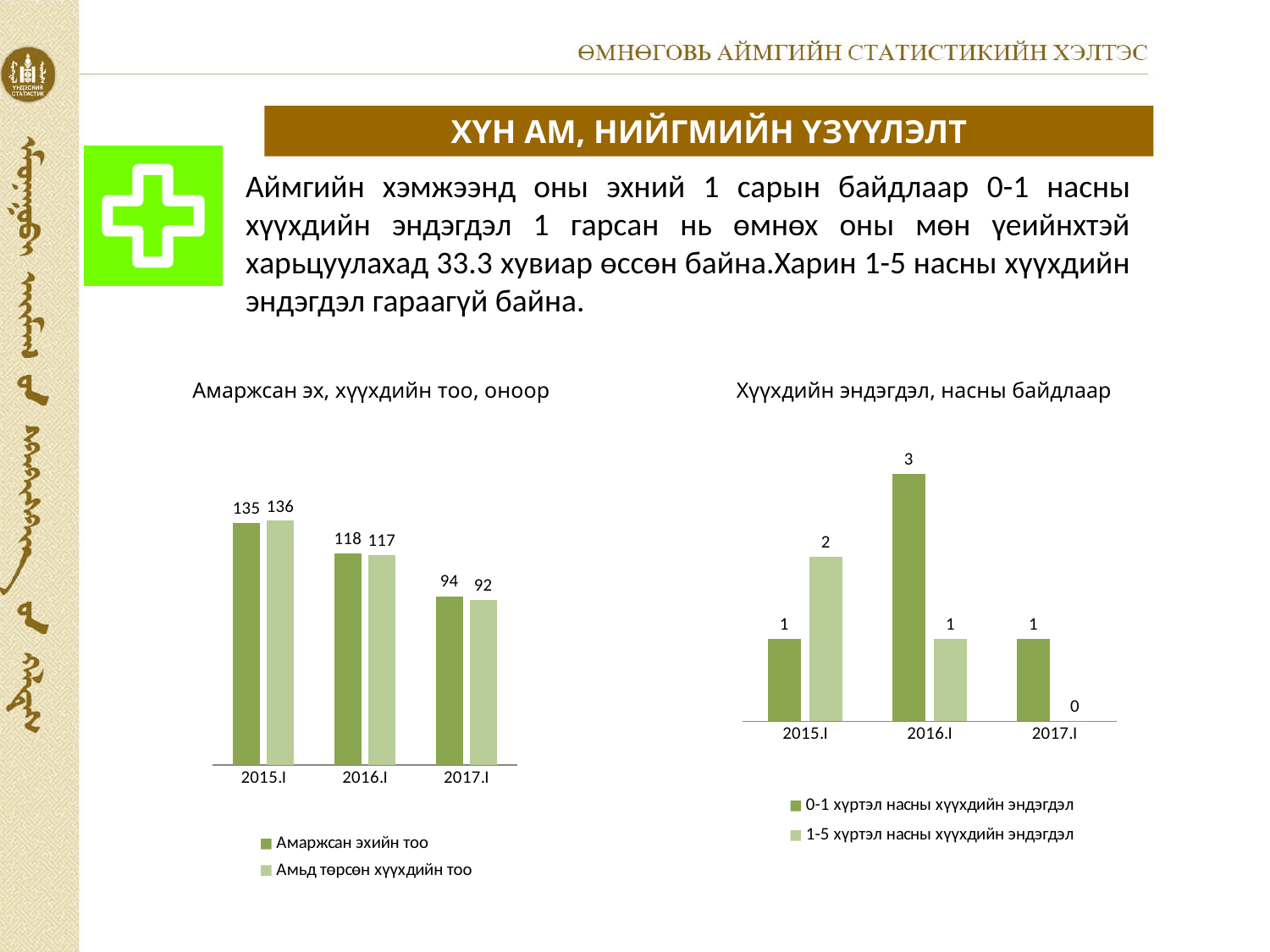
In the chart 'Хүүхдийн эндэгдэл, насны байдлаар', what is the value of '0-1 хүртэл насны хүүхдийн эндэгдэл' for 2016.I? 3 In the chart 'Амаржсан эх, хүүхдийн тоо, оноор', what is the value of 'Амьд төрсөн хүүхдийн тоо' for 2017.I? 92 In the chart 'Амаржсан эх, хүүхдийн тоо, оноор', which period has the lowest value for 'Амаржсан эхийн тоо'? 2017.I In the chart 'Амаржсан эх, хүүхдийн тоо, оноор', how many series does the legend list? 2 In the chart 'Амаржсан эх, хүүхдийн тоо, оноор', what is the value of 'Амаржсан эхийн тоо' for 2015.I? 135 In the chart 'Амаржсан эх, хүүхдийн тоо, оноор', what is the difference between 'Амаржсан эхийн тоо' in 2015.I and 2016.I? 17 In the chart 'Хүүхдийн эндэгдэл, насны байдлаар', which is larger in 2015.I: '0-1 хүртэл насны хүүхдийн эндэгдэл' or '1-5 хүртэл насны хүүхдийн эндэгдэл'? 1-5 хүртэл насны хүүхдийн эндэгдэл What type of chart is 'Хүүхдийн эндэгдэл, насны байдлаар'? bar chart In the chart 'Амаржсан эх, хүүхдийн тоо, оноор', does 'Амаржсан эхийн тоо' rise or fall from 2015.I to 2017.I? fall In the chart 'Хүүхдийн эндэгдэл, насны байдлаар', what is the value of '1-5 хүртэл насны хүүхдийн эндэгдэл' for 2017.I? 0 In the chart 'Хүүхдийн эндэгдэл, насны байдлаар', which period has the highest value for '0-1 хүртэл насны хүүхдийн эндэгдэл'? 2016.I How many periods are shown on the x axis of the chart 'Хүүхдийн эндэгдэл, насны байдлаар'? 3